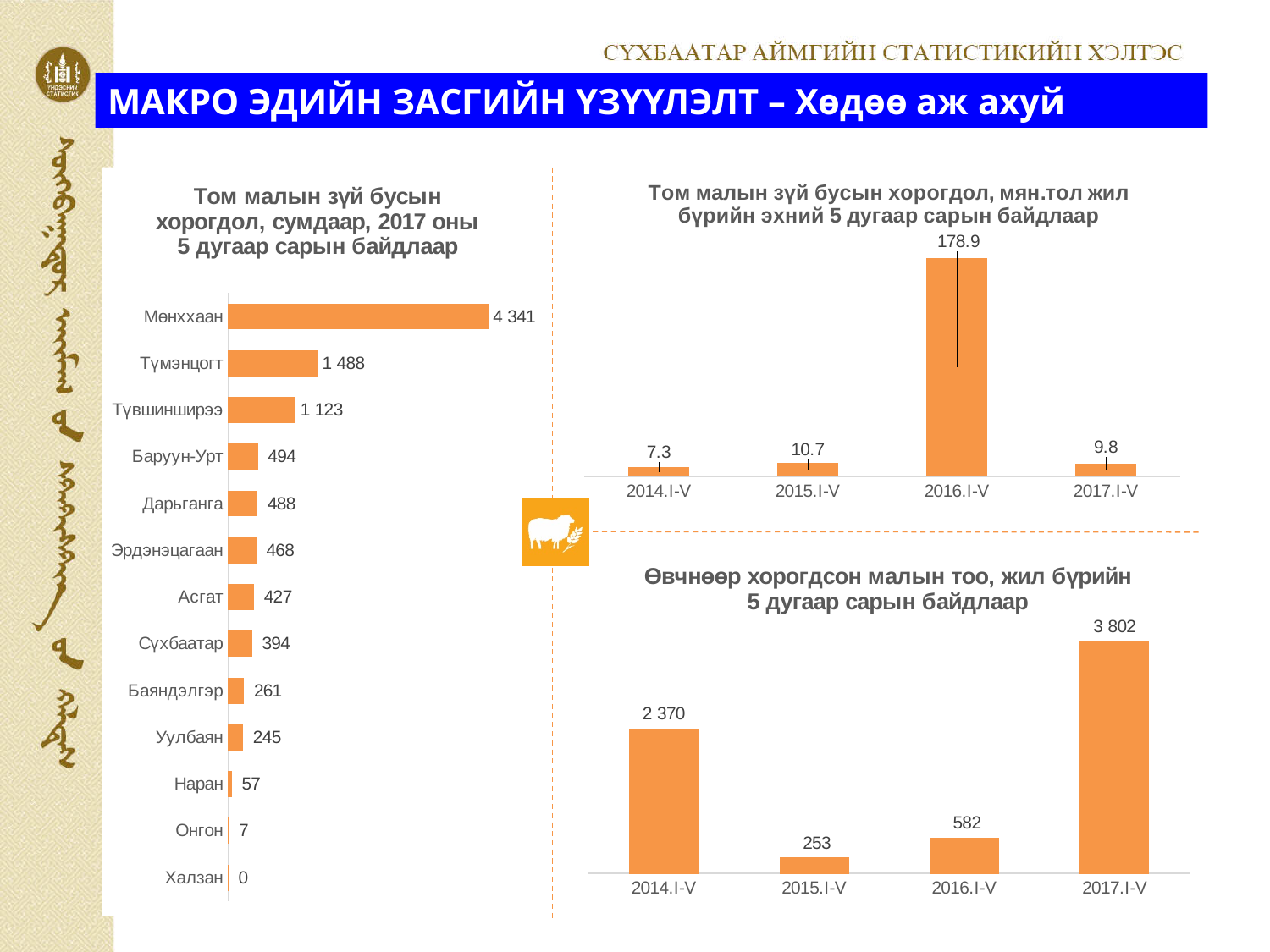
In the left chart (Том малын зүй бусын хорогдол, сумдаар), which is larger, Баруун-Урт or Сүхбаатар? Баруун-Урт In the top-right chart (Том малын зүй бусын хорогдол, мян.тол), what is the difference between 2015.I-V and 2017.I-V? 0.9 In the left chart (Том малын зүй бусын хорогдол, сумдаар), how many soums are listed? 13 In the bottom-right chart (Өвчнөөр хорогдсон малын тоо), what is the value for 2017.I-V? 3 802 In the left chart (Том малын зүй бусын хорогдол, сумдаар), which soum has the lowest value? Халзан In the top-right chart (Том малын зүй бусын хорогдол, мян.тол), which period has the lowest value? 2014.I-V In the bottom-right chart (Өвчнөөр хорогдсон малын тоо), what is the difference between 2014.I-V and 2016.I-V? 1 788 What type of chart is the bottom-right chart (Өвчнөөр хорогдсон малын тоо)? Bar chart In the left chart (Том малын зүй бусын хорогдол, сумдаар), what is the value for Мөнххаан? 4 341 In the left chart (Том малын зүй бусын хорогдол, сумдаар), what is the difference between Түмэнцогт and Түвшинширээ? 365 In the left chart (Том малын зүй бусын хорогдол, сумдаар), what is the value for Наран? 57 In the top-right chart (Том малын зүй бусын хорогдол, мян.тол), what is the value for 2016.I-V? 178.9